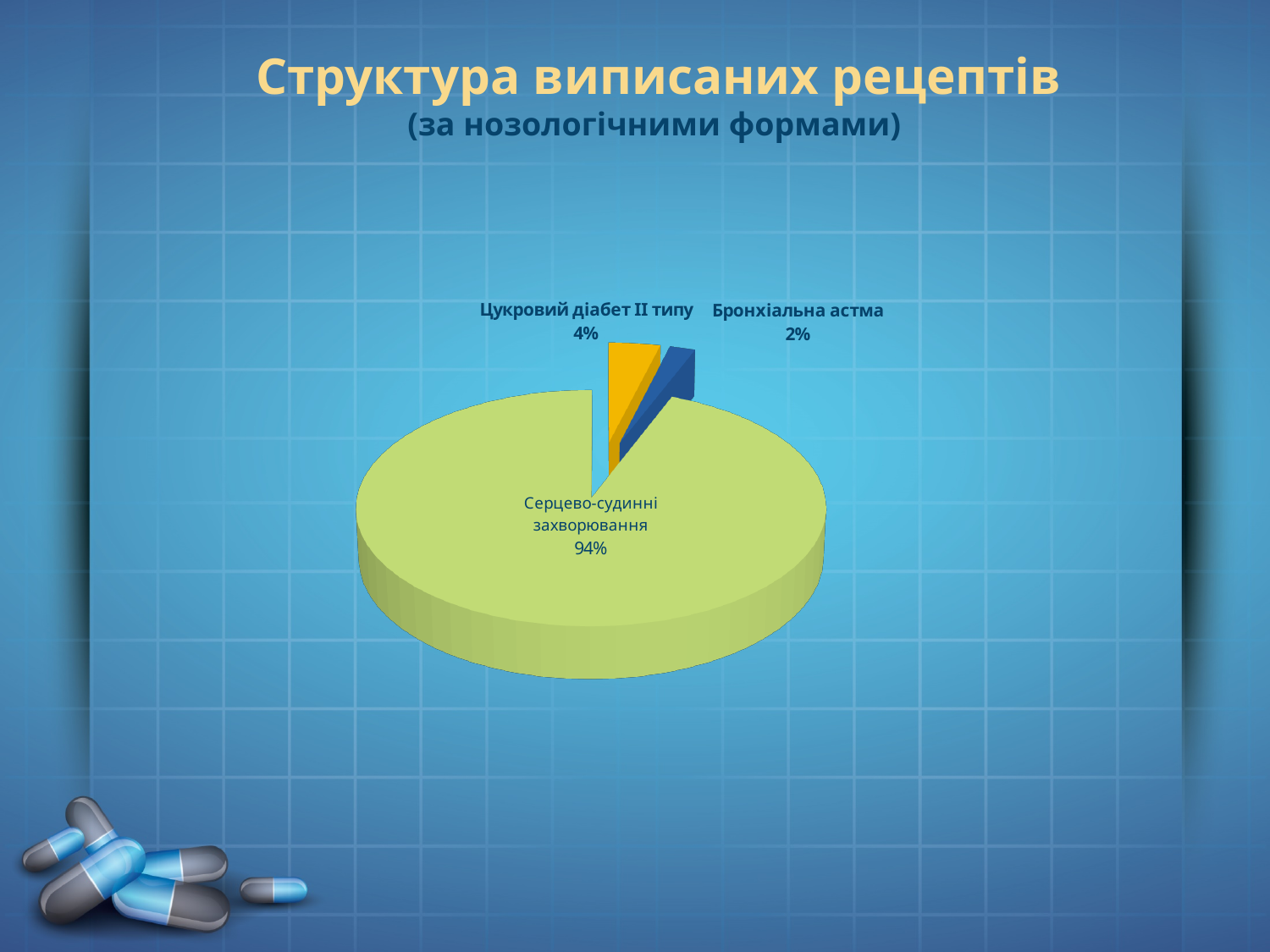
How many slices does the pie chart have? 3 What is the difference in percentage points between Серцево-судинні захворювання and Цукровий діабет II типу? 90% What share of the pie does Серцево-судинні захворювання have? 94% Which is larger, the share for Цукровий діабет II типу or the share for Бронхіальна астма? Цукровий діабет II типу What share of the pie does Цукровий діабет II типу have? 4% Which category has the largest slice of the pie? Серцево-судинні захворювання What is the difference in percentage points between Цукровий діабет II типу and Бронхіальна астма? 2% What share of the pie does Бронхіальна астма have? 2% Which category has the smallest slice of the pie? Бронхіальна астма What kind of chart is shown on the slide? pie chart What colour is the slice for Серцево-судинні захворювання? light green What is the title of the slide containing the chart? Структура виписаних рецептів (за нозологічними формами)